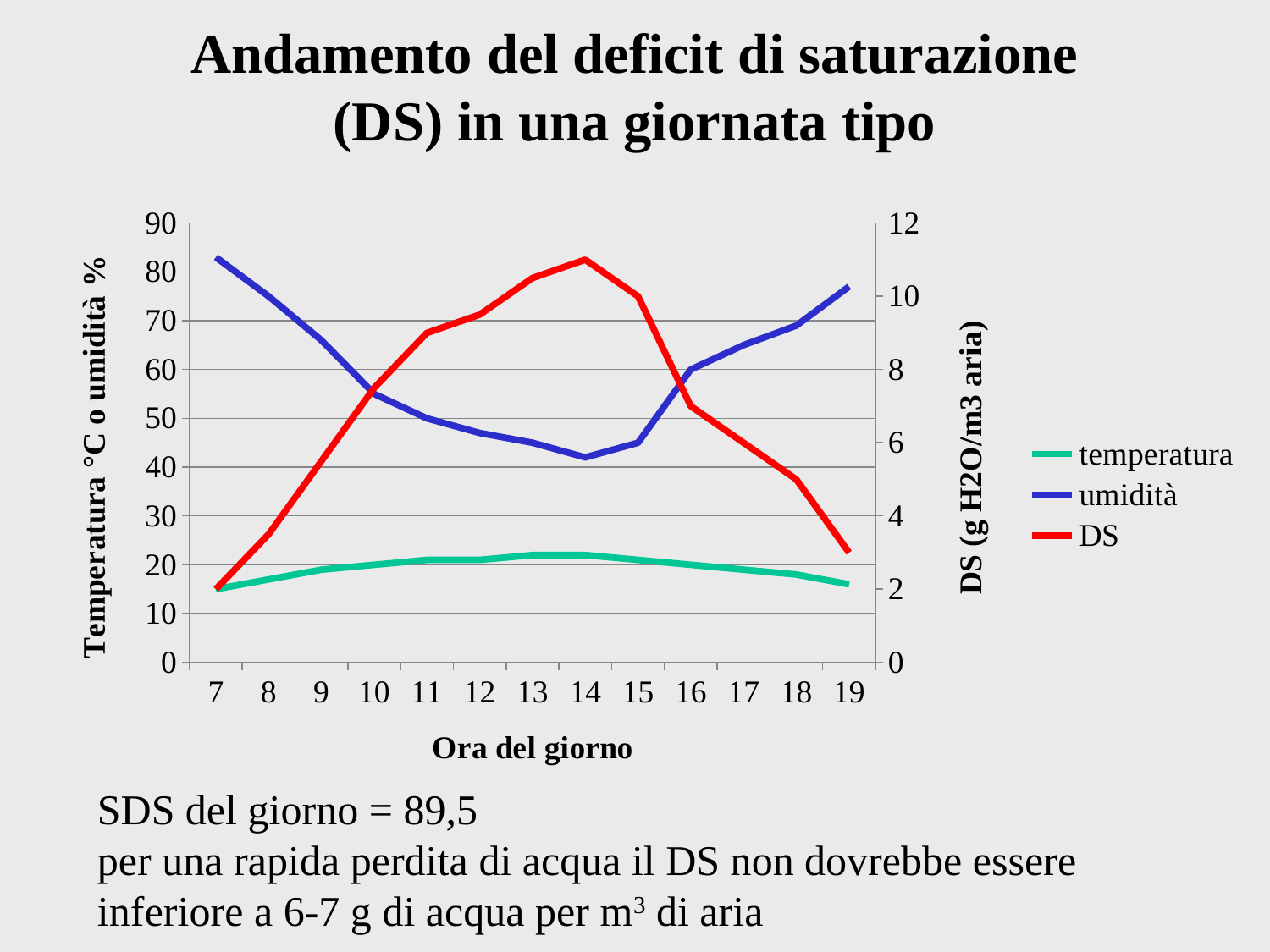
What kind of chart is shown on the slide? line chart Is the DS value at hour 7 greater or less than 4? less What is the title of the x axis? Ora del giorno Which is larger, the umidità value at hour 7 or at hour 19? hour 7 How many hours (points) are plotted along the x axis? 13 Is the umidità value at hour 14 greater or less than 50? less Does the DS line rise or fall from hour 7 to hour 14? rises How many series does the legend list? 3 At which hour is umidità lowest? 14 At which hour does DS reach its highest value? 14 Is the DS value at hour 14 greater or less than 10? greater At which hour is umidità highest? 7